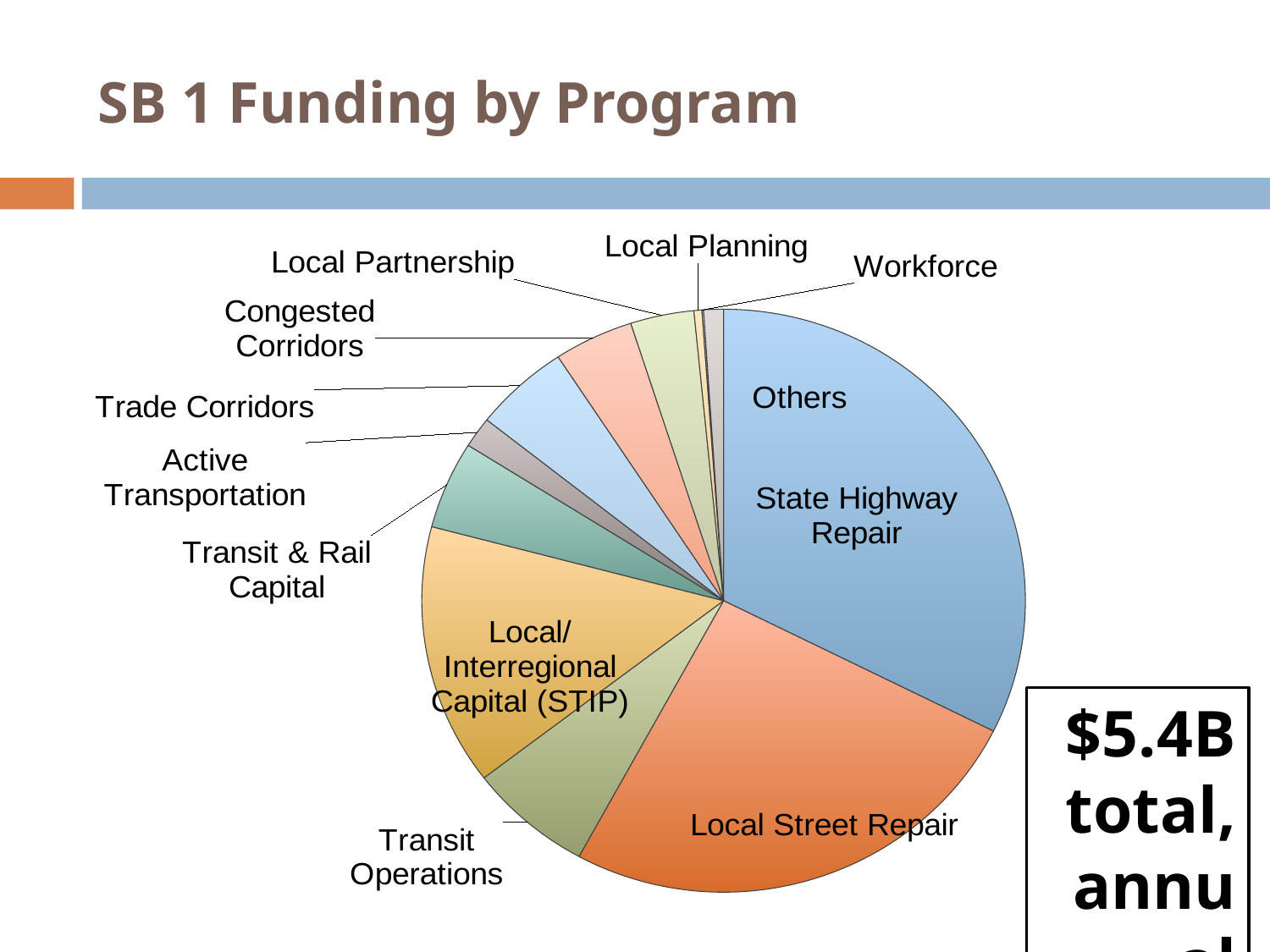
Which slice is larger, Local/Interregional Capital (STIP) or Transit Operations? Local/Interregional Capital (STIP) Which program receives the largest share of SB 1 funding in the pie chart? State Highway Repair Which slice is larger, Local Street Repair or Local/Interregional Capital (STIP)? Local Street Repair Which slice is larger, State Highway Repair or Transit & Rail Capital? State Highway Repair What is the title of the chart on the slide? SB 1 Funding by Program How many slices does the pie chart have? 12 What total annual funding amount is stated in the box next to the pie chart? $5.4B What kind of chart is shown on the slide? pie chart